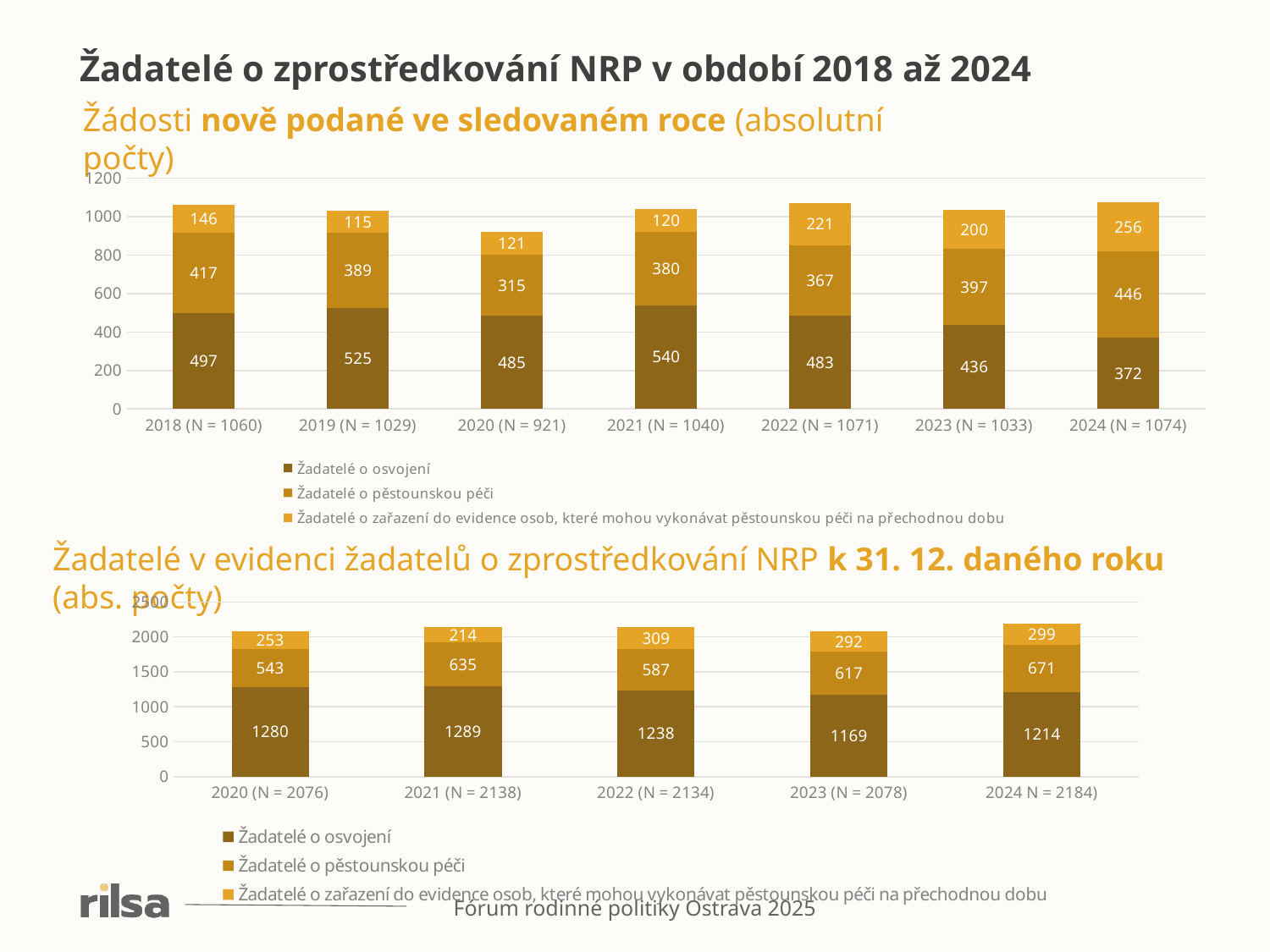
What kind of chart is the bottom chart (Žadatelé v evidenci žadatelů o zprostředkování NRP k 31. 12. daného roku)? Stacked bar chart In the bottom chart (Žadatelé v evidenci žadatelů o zprostředkování NRP k 31. 12. daného roku), how many series does the legend list? 3 In the top chart (Žádosti nově podané ve sledovaném roce), what is the value for Žadatelé o osvojení in 2021? 540 In the top chart (Žádosti nově podané ve sledovaném roce), how many years are shown on the x axis? 7 In the top chart (Žádosti nově podané ve sledovaném roce), what is the difference between the Žadatelé o osvojení values for 2019 and 2024? 153 In the top chart (Žádosti nově podané ve sledovaném roce), what is the total of the stacked bar for 2022? 1071 In the top chart (Žádosti nově podané ve sledovaném roce), what is the value for Žadatelé o pěstounskou péči in 2024? 446 In the top chart (Žádosti nově podané ve sledovaném roce), which year has the highest value for Žadatelé o osvojení? 2021 (N = 1040) In the top chart (Žádosti nově podané ve sledovaném roce), which year has the lowest value for Žadatelé o pěstounskou péči? 2020 (N = 921) In the bottom chart (Žadatelé v evidenci žadatelů o zprostředkování NRP k 31. 12. daného roku), what is the value for Žadatelé o osvojení in 2023? 1169 In the bottom chart (Žadatelé v evidenci žadatelů o zprostředkování NRP k 31. 12. daného roku), is the value for Žadatelé o zařazení do evidence osob larger in 2022 or in 2021? 2022 In the bottom chart (Žadatelé v evidenci žadatelů o zprostředkování NRP k 31. 12. daného roku), which year has the highest value for Žadatelé o pěstounskou péči? 2024 N = 2184)